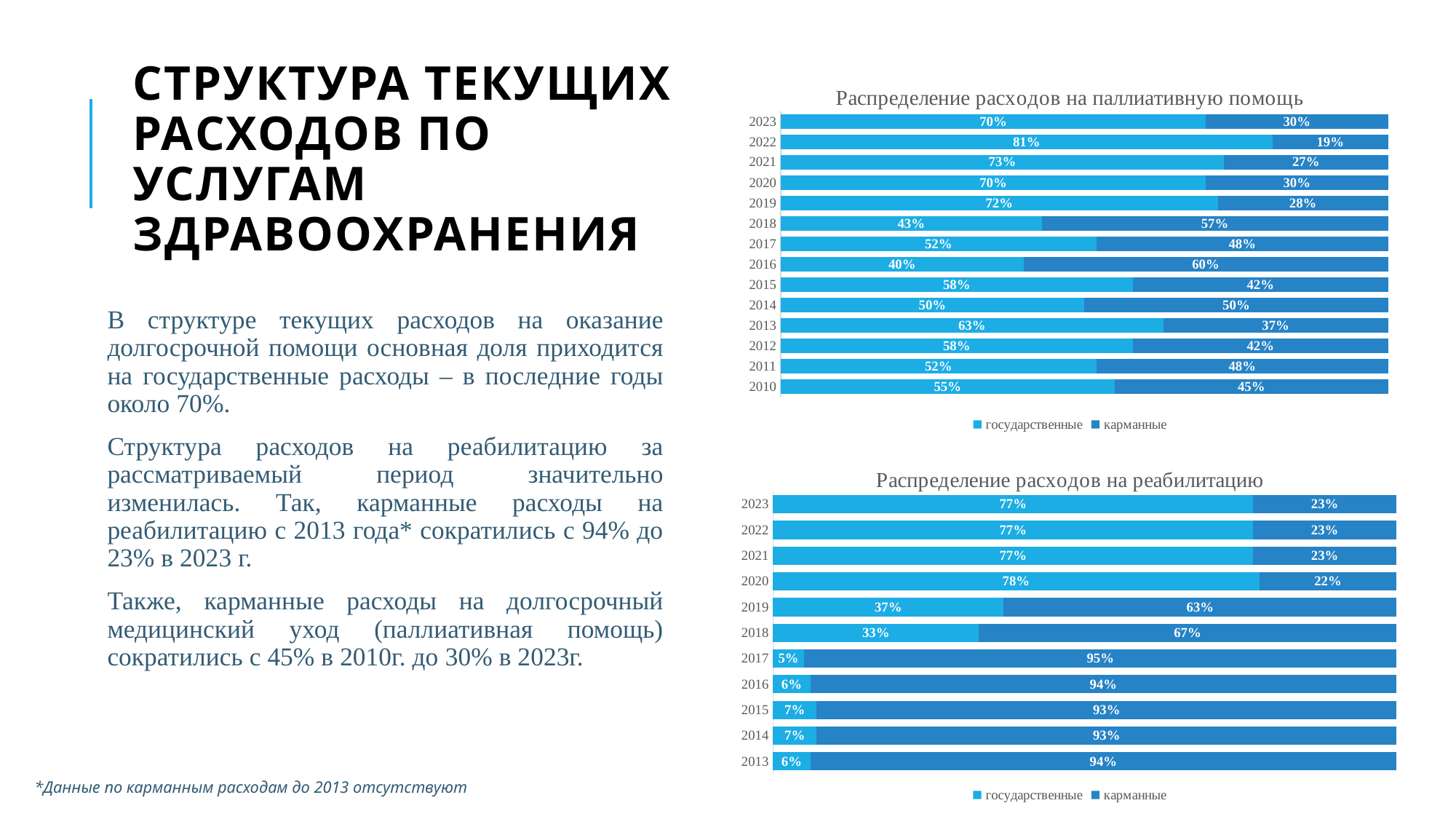
In the chart 'Распределение расходов на паллиативную помощь', what is the value for карманные in 2016? 60% In the chart 'Распределение расходов на паллиативную помощь', which year has the highest value for государственные? 2022 In the chart 'Распределение расходов на паллиативную помощь', how many years are shown? 14 In the chart 'Распределение расходов на реабилитацию', how many series does the legend list? 2 In the chart 'Распределение расходов на паллиативную помощь', what is the difference between the карманные values for 2010 and 2023? 15% In the chart 'Распределение расходов на реабилитацию', which year has the highest value for карманные? 2017 In the chart 'Распределение расходов на реабилитацию', what is the value for государственные in 2020? 78% In the chart 'Распределение расходов на реабилитацию', which is larger in 2019: государственные or карманные? карманные What kind of chart is 'Распределение расходов на реабилитацию'? Stacked bar chart In the chart 'Распределение расходов на паллиативную помощь', what is the value for государственные in 2023? 70% In the chart 'Распределение расходов на паллиативную помощь', which year has the lowest value for государственные? 2016 In the chart 'Распределение расходов на реабилитацию', what is the value for карманные in 2013? 94%